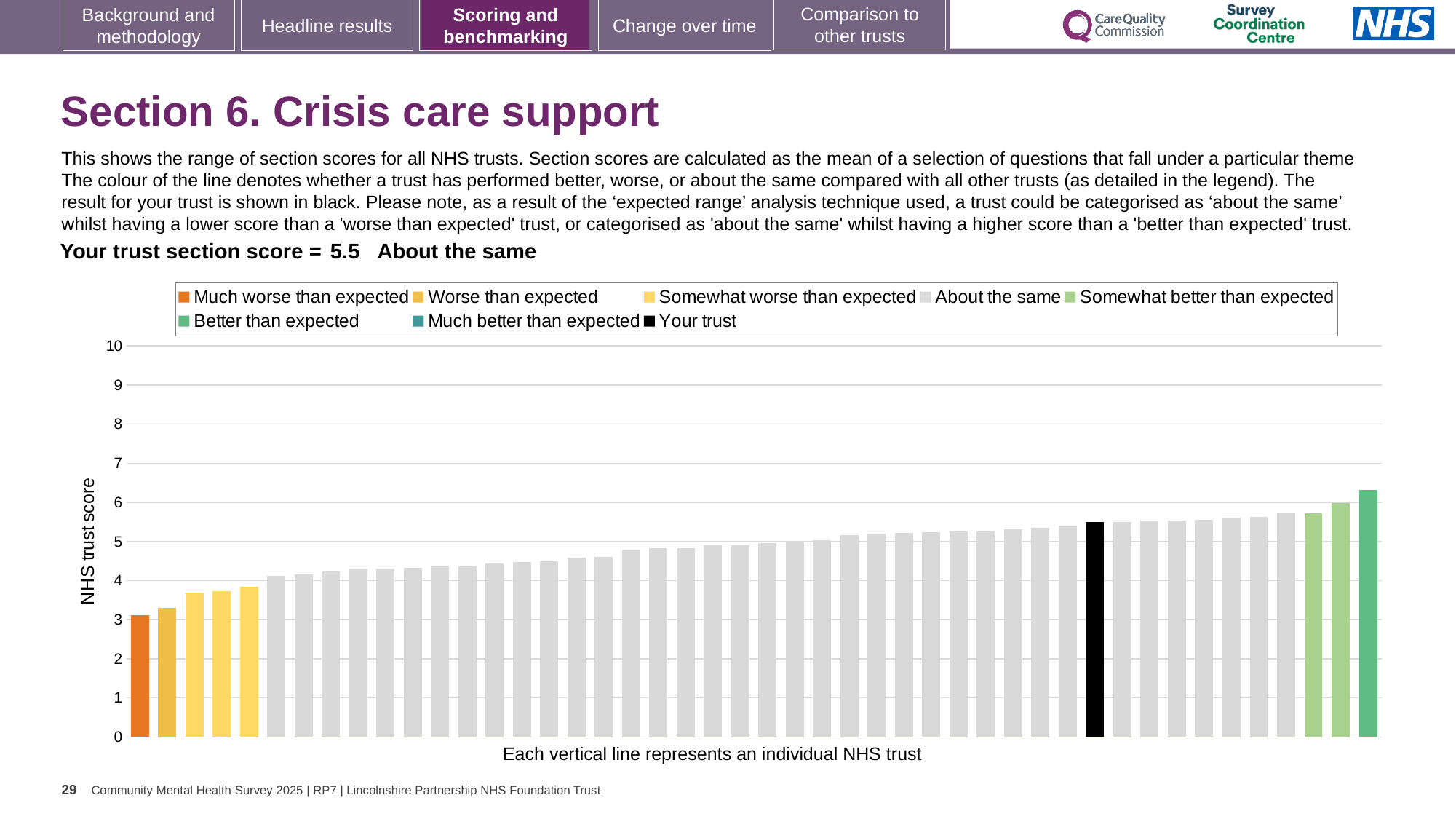
Is the value of the lowest bar (the orange one) greater or less than 4? less What is the label on the vertical axis of the chart? NHS trust score What is the section score for your trust shown on the slide? 5.5 Which legend category does the lowest bar in the chart belong to? Much worse than expected Which legend category is your trust's section score placed in? About the same What kind of chart is shown on the slide? bar chart Is the value of the black 'Your trust' bar greater or less than 6? less Which legend category does the highest bar in the chart belong to? Better than expected How many entries does the chart legend list? 8 Is the value of the black 'Your trust' bar greater or less than 5? greater Do the bar values rise or fall from left to right along the x axis? rise